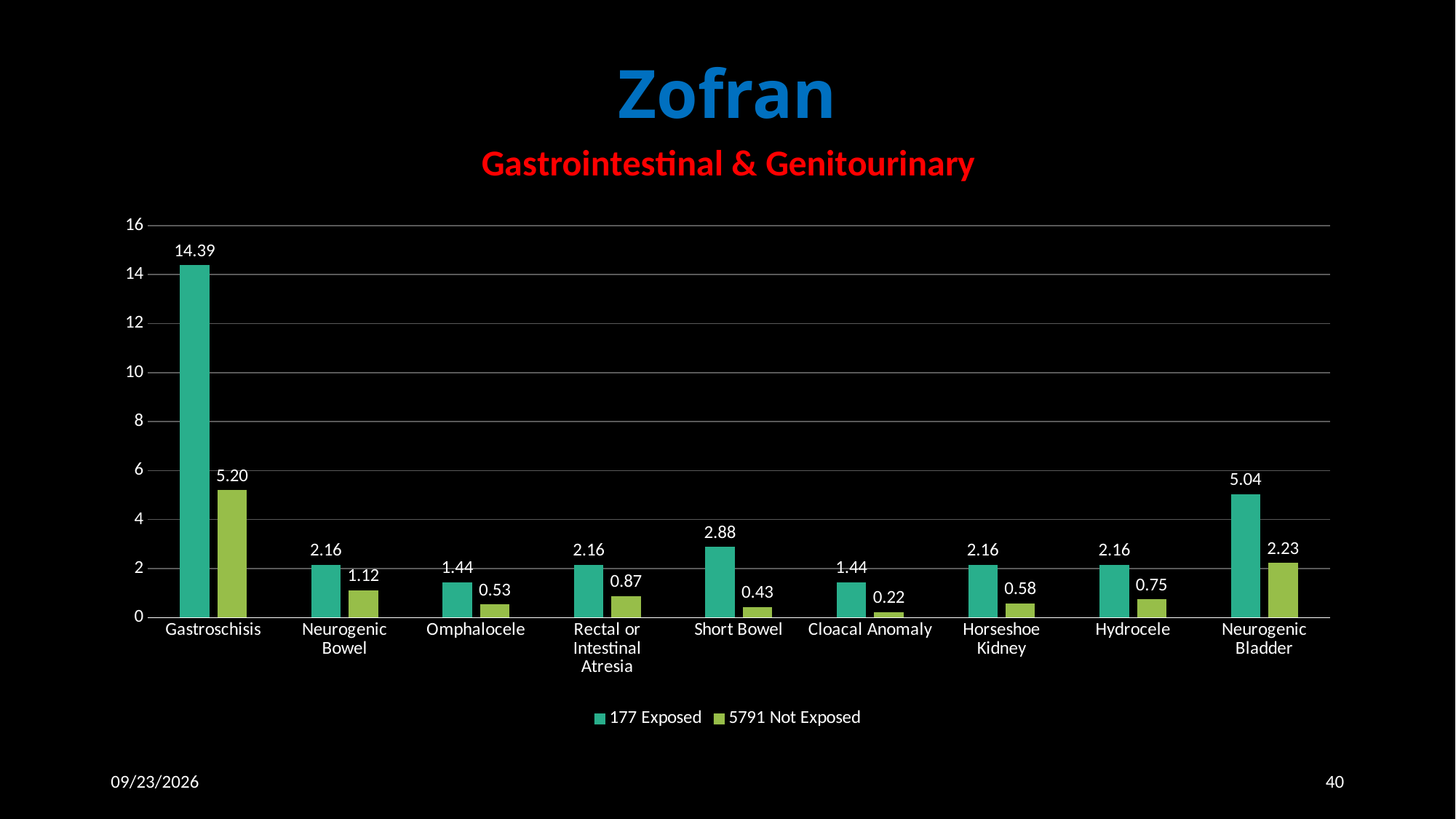
What is the value for Cloacal Anomaly in the 5791 Not Exposed series? 0.22 Is the 5791 Not Exposed value for Gastroschisis greater or less than 4? greater What is the difference between the 177 Exposed and 5791 Not Exposed values for Gastroschisis? 9.19 What is the value for Neurogenic Bladder in the 5791 Not Exposed series? 2.23 How many categories are shown on the x axis? 9 What is the difference between the 177 Exposed and 5791 Not Exposed values for Short Bowel? 2.45 What kind of chart is shown on the slide? bar chart Which category has the highest value in the 177 Exposed series? Gastroschisis Which category has the lowest value in the 5791 Not Exposed series? Cloacal Anomaly How many series does the legend list? 2 Which is larger: the 177 Exposed value for Neurogenic Bladder or the 177 Exposed value for Short Bowel? Neurogenic Bladder What is the value for Gastroschisis in the 177 Exposed series? 14.39